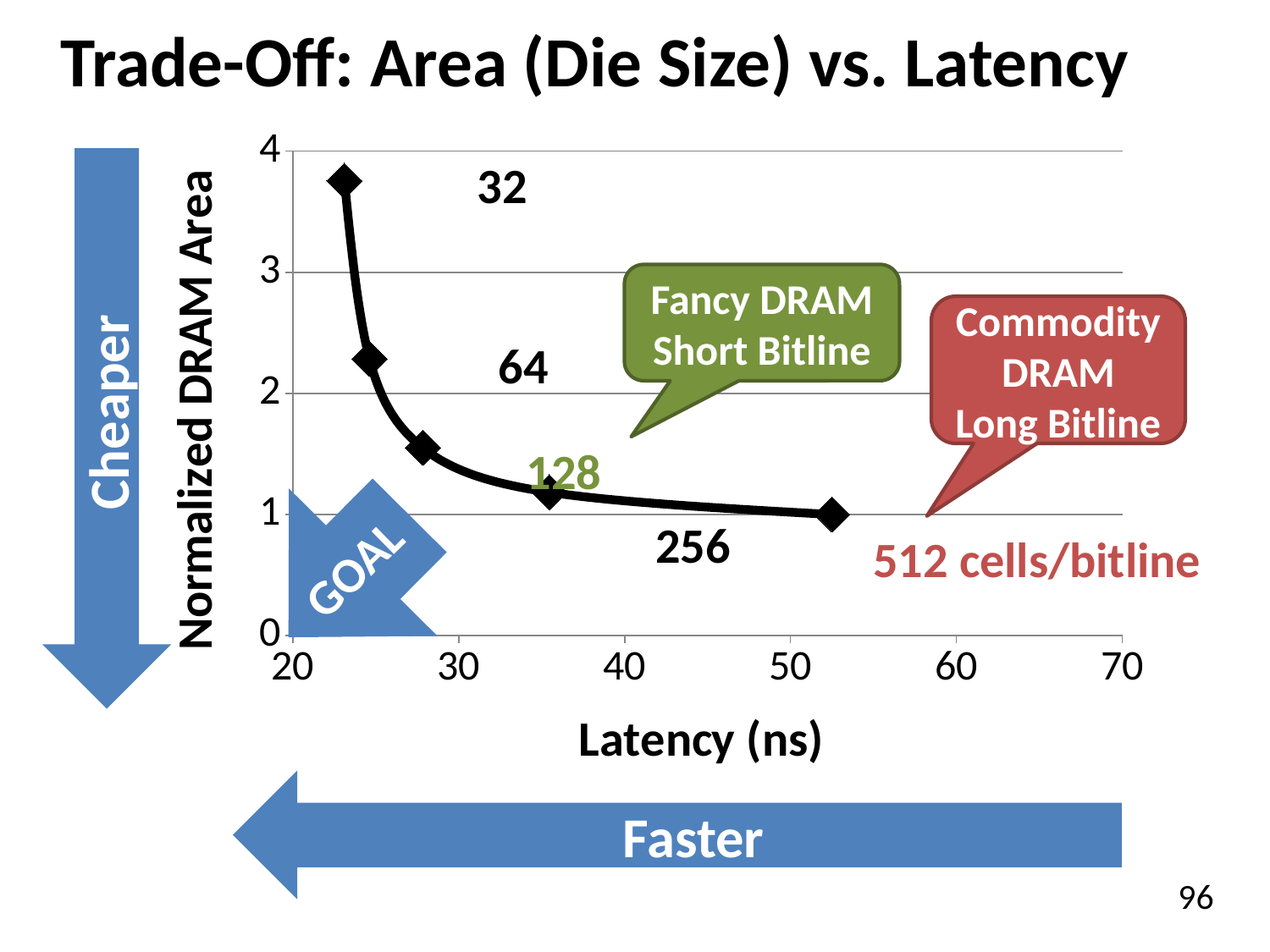
Is the normalized DRAM area for the point labeled 32 greater or less than 3? greater What is the title of the y axis? Normalized DRAM Area Which labeled point has the lowest normalized DRAM area? 512 cells/bitline How many data points are plotted on the curve? 5 As latency increases along the x axis, does the normalized DRAM area rise or fall? fall Which has a larger normalized DRAM area, the point labeled 64 or the point labeled 256? 64 Is the latency for the point labeled 512 cells/bitline greater or less than 50? greater Which labeled point has the lowest latency? 32 What kind of chart is shown on the slide? line chart Is the normalized DRAM area for the point labeled 128 greater or less than 2? less What is the title of the x axis? Latency (ns) Which labeled point has the highest normalized DRAM area? 32